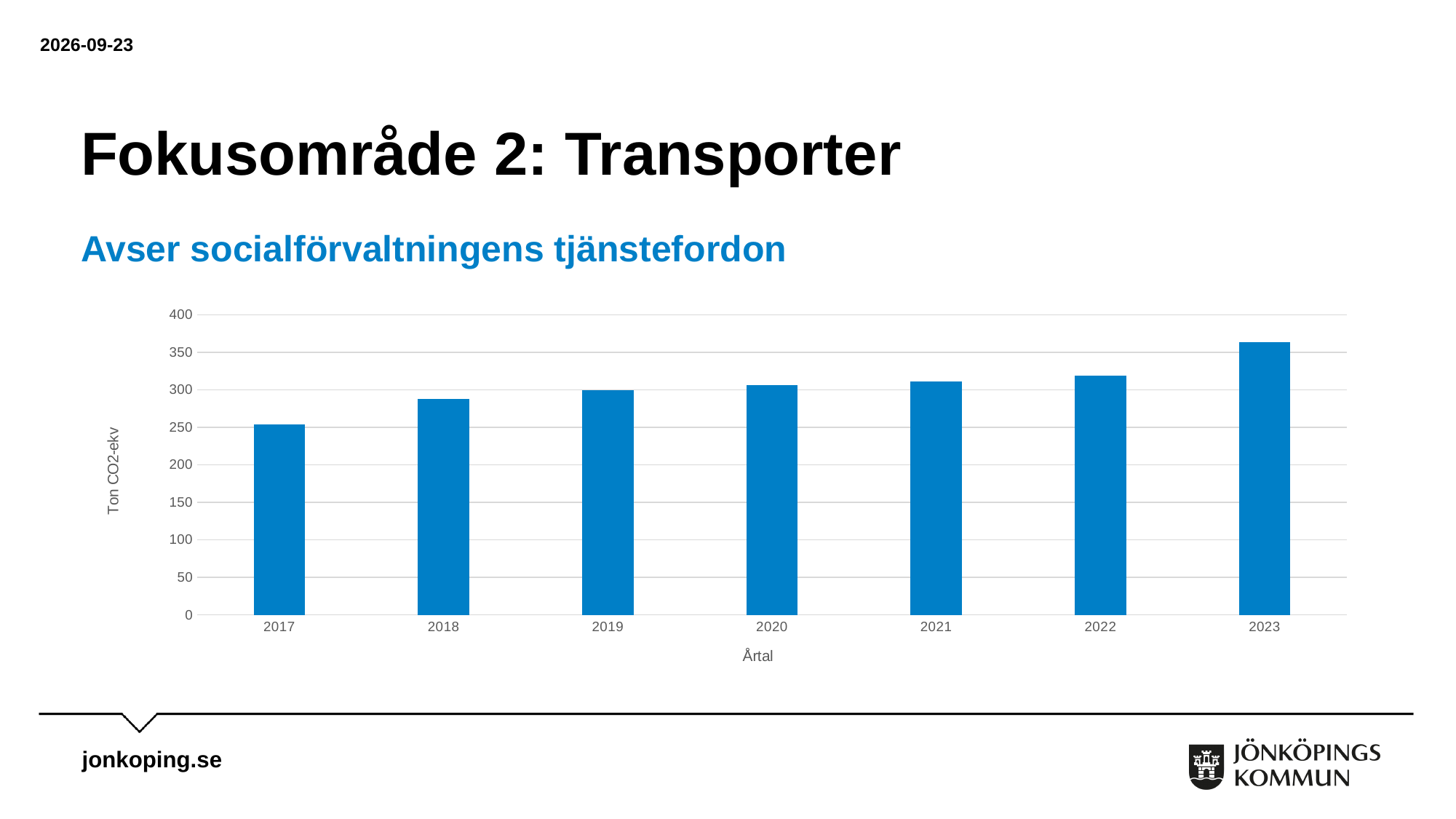
Which year has the lowest value in the chart? 2017 What is the label on the horizontal axis of the chart? Årtal What is the label on the vertical axis of the chart? Ton CO2-ekv Is the value for 2017 greater or less than 300? less What kind of chart is shown on the slide? Bar chart Which year has the highest value in the chart? 2023 Is the value for 2018 greater or less than 300? less Is the value for 2023 greater or less than 350? greater How many years are shown on the x axis of the chart? 7 Which year has the larger value, 2018 or 2022? 2022 Do the values rise or fall from 2017 to 2023? Rise